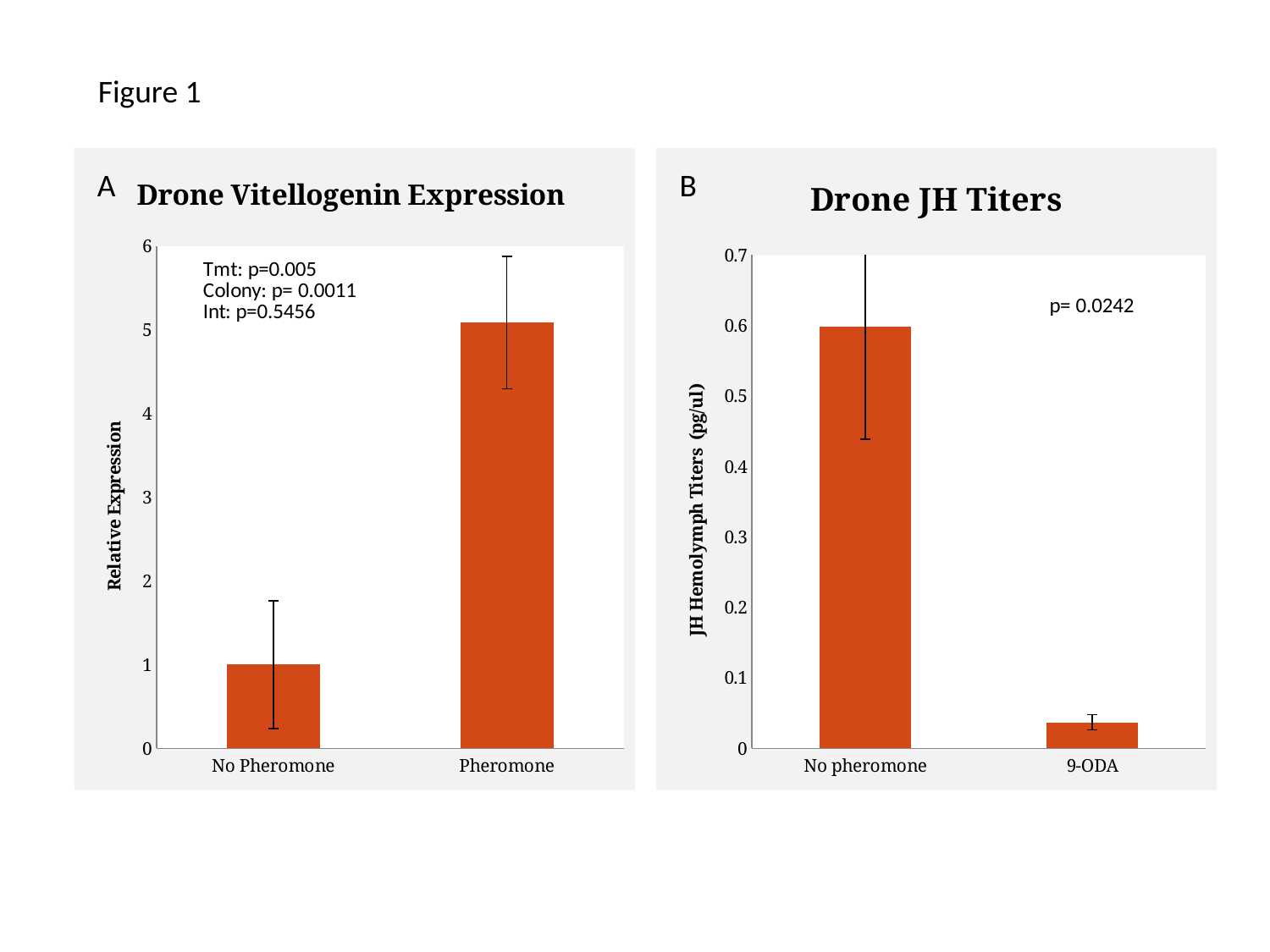
In the Drone JH Titers chart, is the value for No pheromone greater or less than 0.5? greater In the Drone JH Titers chart, is the value for 9-ODA greater or less than 0.1? less In the Drone Vitellogenin Expression chart, is the value for Pheromone greater or less than 4? greater How many categories are shown in the Drone Vitellogenin Expression chart? 2 In the Drone Vitellogenin Expression chart, which category has the highest relative expression? Pheromone What p-value is printed on the Drone JH Titers chart? p= 0.0242 In the Drone Vitellogenin Expression chart, what is the relative expression for No Pheromone? 1 What kind of chart is the Drone JH Titers chart? Bar chart In the Drone Vitellogenin Expression chart, which category has the lowest relative expression? No Pheromone In the Drone JH Titers chart, which category has the higher JH hemolymph titer? No pheromone What is the y-axis label of the Drone JH Titers chart? JH Hemolymph Titers (pg/ul)